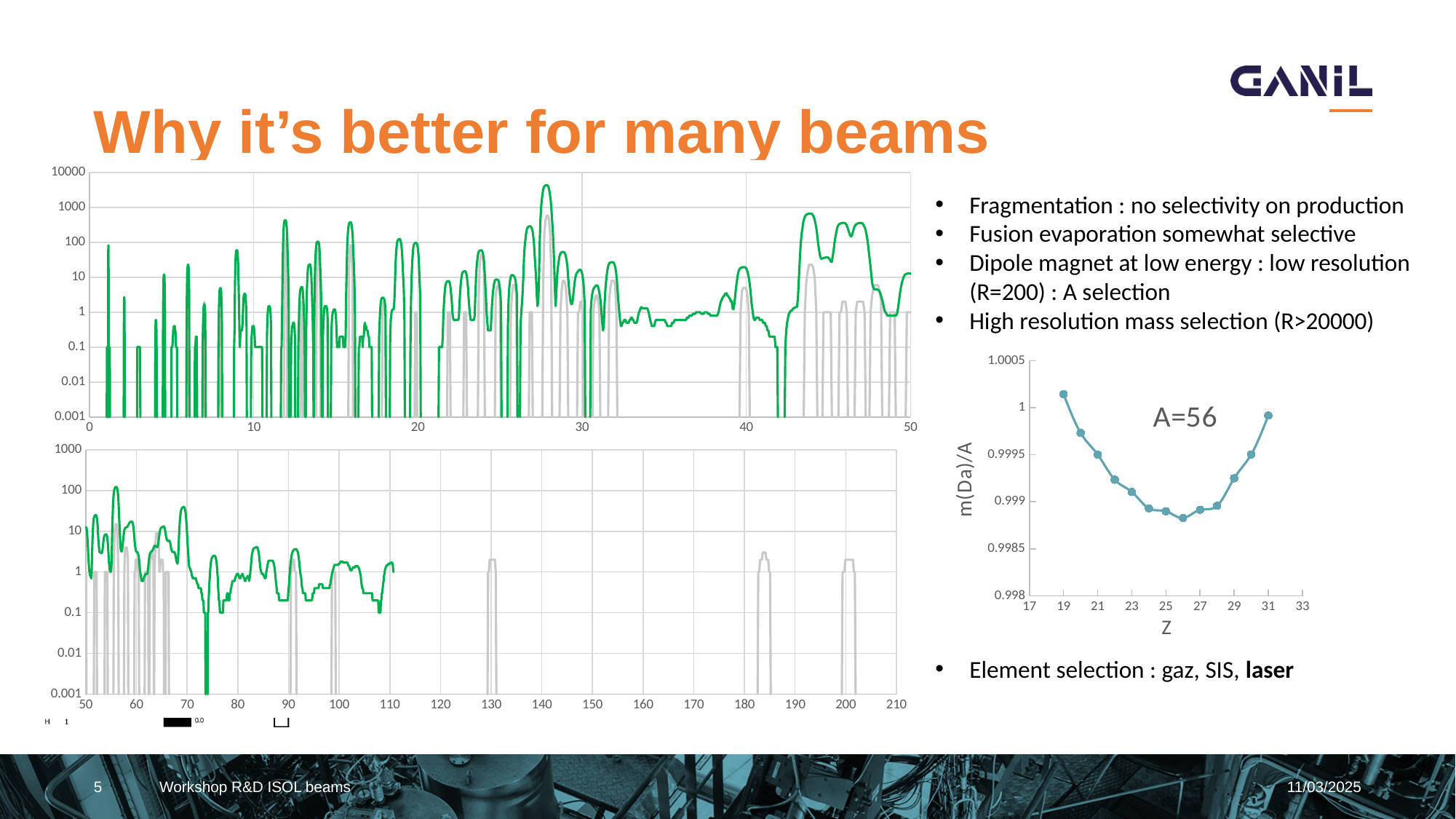
In the chart titled A=56, which has the larger m(Da)/A value, Z=19 or Z=31? Z=19 In the top-left chart, is the highest green peak (near x=28) greater or less than 1000? greater In the chart titled A=56, how many data points are plotted? 13 In the chart titled A=56, is the value at Z=26 greater or less than 0.999? less In the chart titled A=56, what is the label of the x axis? Z In the chart titled A=56, is the value at Z=19 greater or less than 1? greater In the chart titled A=56, at which value of Z is m(Da)/A lowest? 26 In the chart titled A=56, what kind of chart is it? line chart In the chart titled A=56, at which value of Z is m(Da)/A highest? 19 In the chart titled A=56, what is the label of the y axis? m(Da)/A